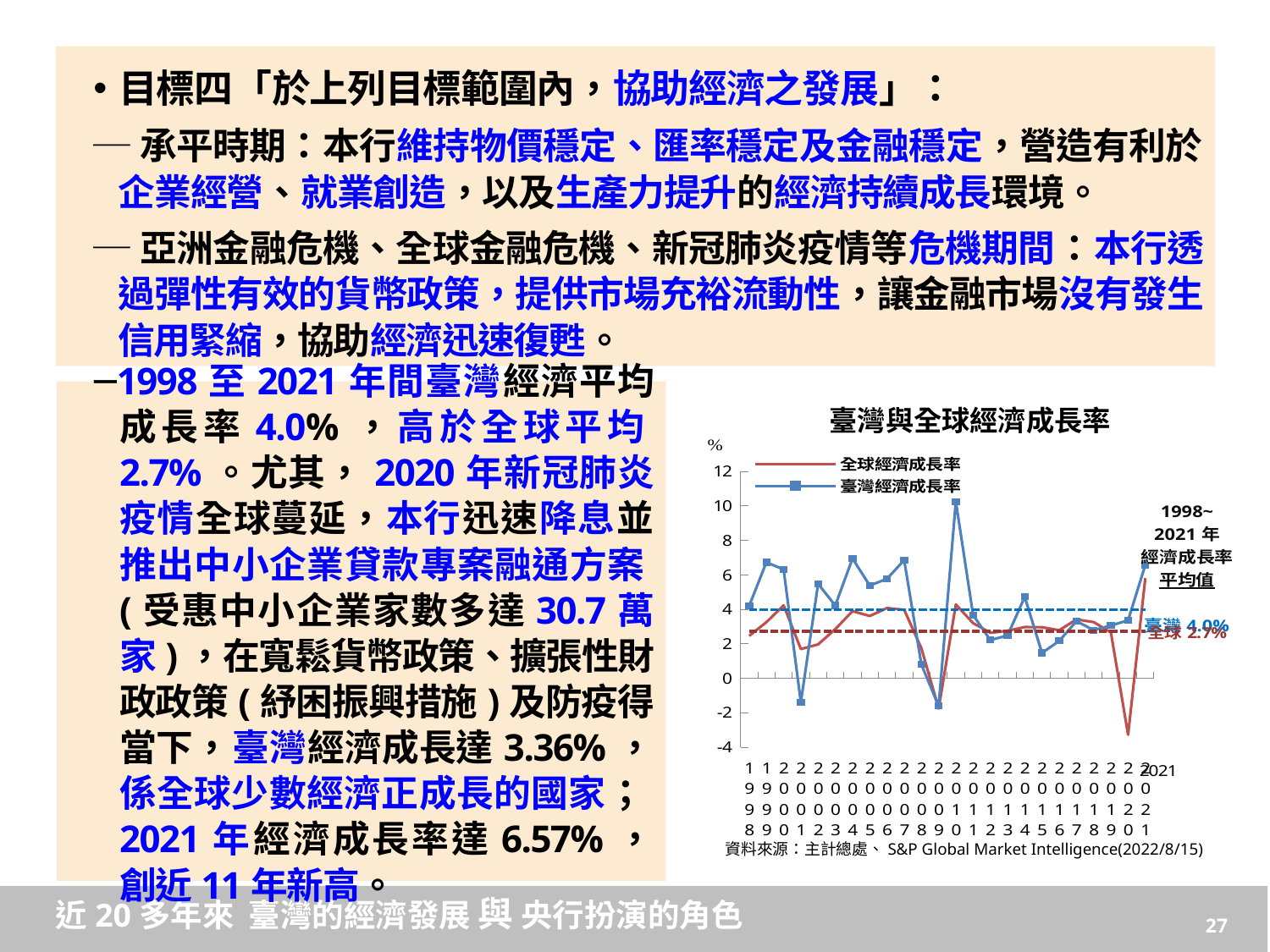
Is the 臺灣經濟成長率 value for 2010 greater or less than 8? greater In which year does the 全球經濟成長率 line reach its lowest value? 2020 What kind of chart is shown on the slide? line chart What is the title of the chart? 臺灣與全球經濟成長率 In which year does the 臺灣經濟成長率 line reach its highest value? 2010 Which series is drawn in blue with square markers? 臺灣經濟成長率 By how much does Taiwan's 1998–2021 average growth rate exceed the global average shown on the chart? 1.3% How many series does the chart's legend list? 2 According to the chart annotation, what is Taiwan's average economic growth rate for 1998–2021? 4.0% Is the 全球經濟成長率 value for 2020 greater or less than -2? less Which 1998–2021 average growth rate shown on the chart is higher, 臺灣 or 全球? 臺灣 According to the chart annotation, what is the global average economic growth rate for 1998–2021? 2.7%